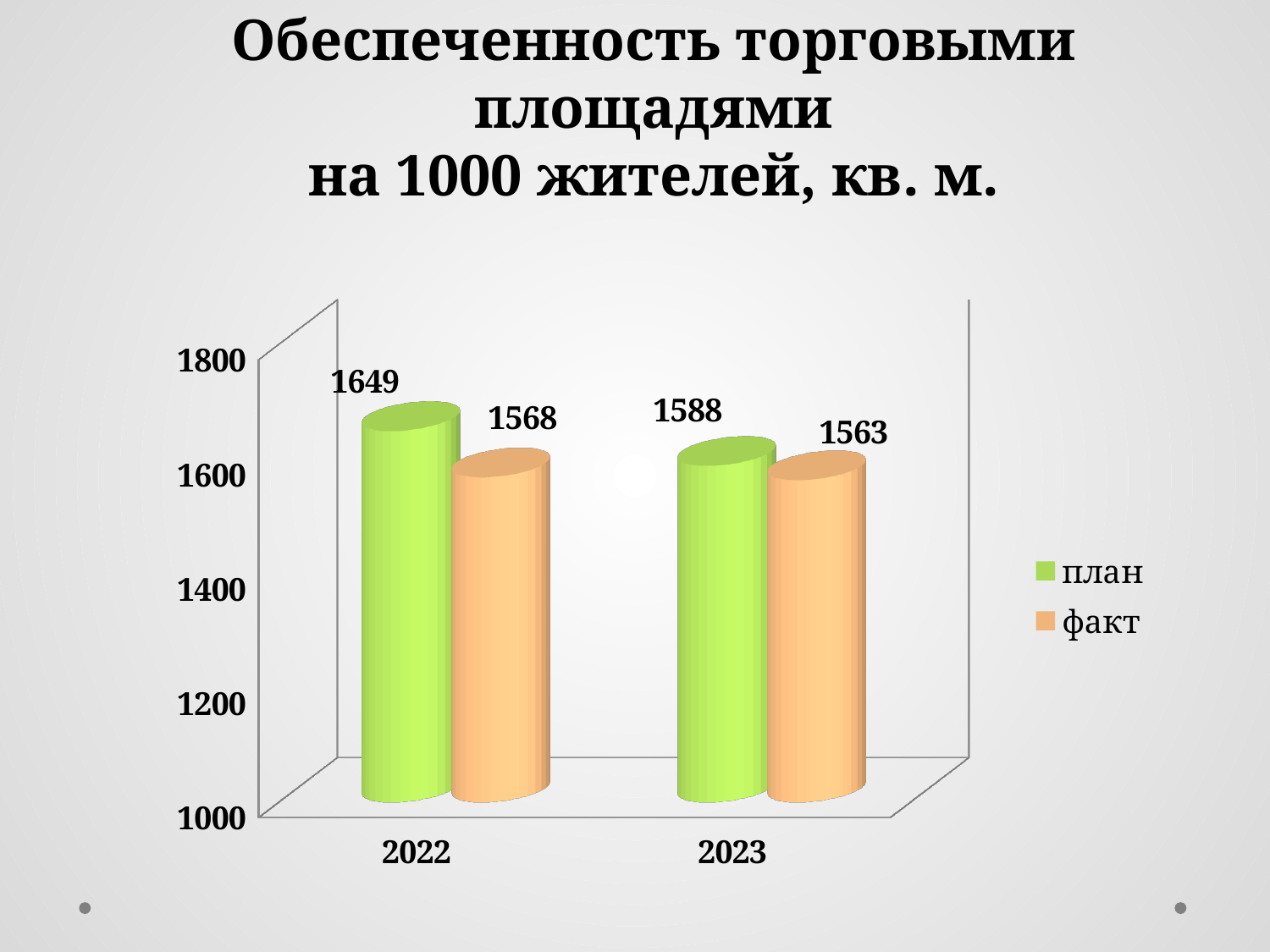
What is the факт value for 2022? 1568 How many years are shown on the x axis? 2 How many series does the legend list? 2 Which year has the lowest факт value? 2023 Which year has the highest план value? 2022 What is the план value for 2023? 1588 What is the difference between план and факт in 2023? 25 What kind of chart is shown on the slide? bar chart What is the план value for 2022? 1649 What is the difference between план and факт in 2022? 81 What is the факт value for 2023? 1563 Which is larger in 2022, план or факт? план